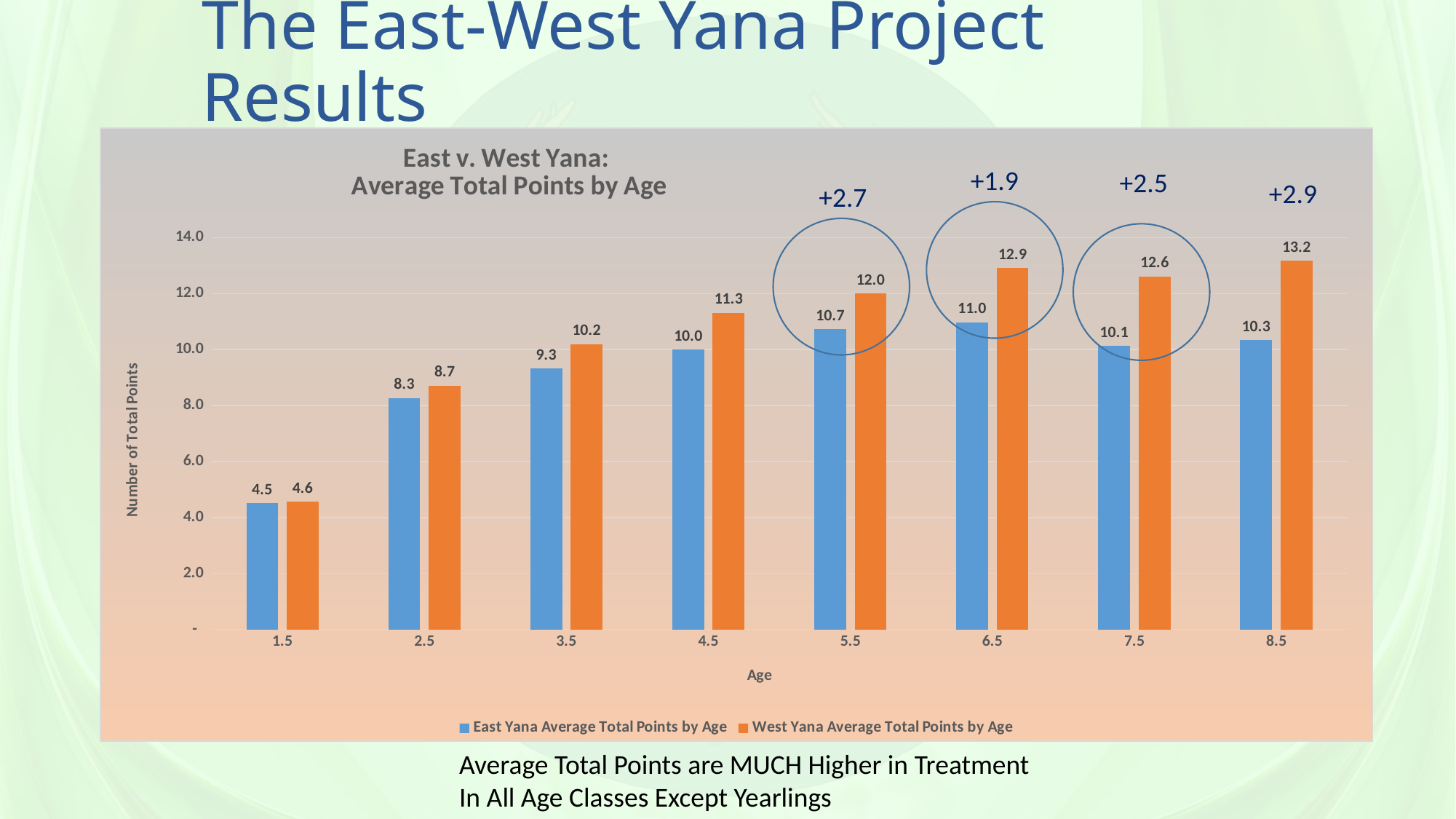
Which age class has the highest West Yana average total points? 8.5 Which age class has the lowest East Yana average total points? 1.5 What is the difference between the West Yana and East Yana average total points at age 6.5? 1.9 What is the title of the chart? East v. West Yana: Average Total Points by Age At age 7.5, which series has the larger value, East Yana or West Yana? West Yana How many series does the legend list? 2 What is the West Yana average total points for age 3.5? 10.2 What kind of chart is shown on the slide? Bar chart Is the East Yana value for age 4.5 greater or less than 8.0? greater What is the West Yana average total points for age 8.5? 13.2 What is the East Yana average total points for age 5.5? 10.7 How many age classes are shown on the x axis? 8